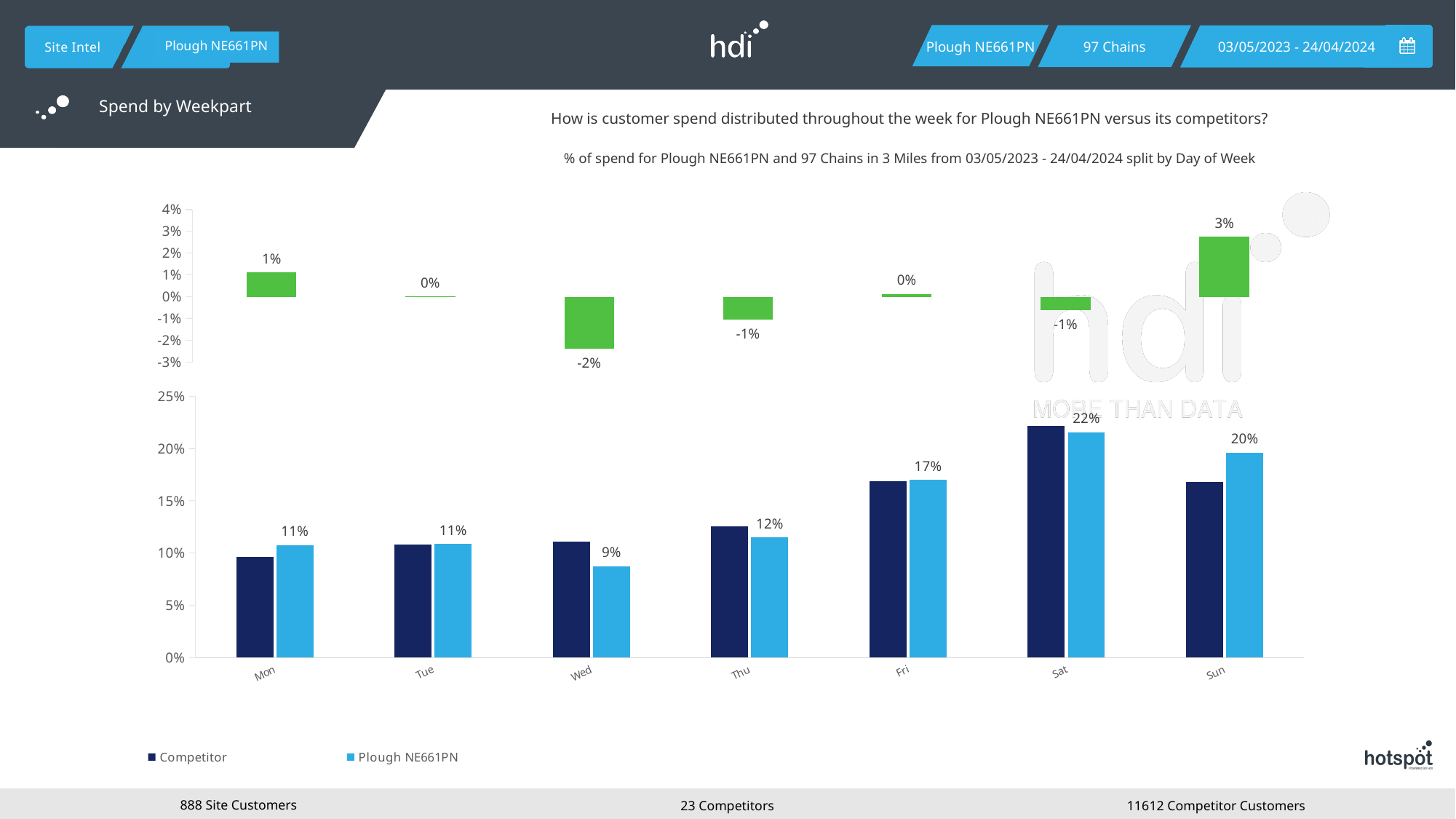
How many series does the legend of the bottom bar chart list? 2 In the bottom bar chart, what is the value for Plough NE661PN on Wed? 9% In the bottom bar chart, what is the difference between the Plough NE661PN values for Sat and Sun? 2% In the bottom bar chart, which day has the highest Plough NE661PN value? Sat In the bottom bar chart, is the Competitor value for Sat greater or less than 20%? greater In the top chart, which day has the lowest value? Wed How many days of the week are shown on the x axis of the bottom bar chart? 7 In the bottom bar chart, what is the value for Plough NE661PN on Sat? 22% In the bottom bar chart, which is larger on Sun: the Competitor bar or the Plough NE661PN bar? Plough NE661PN In the top chart, what is the value shown for Sun? 3% In the bottom bar chart, which day has the lowest Plough NE661PN value? Wed